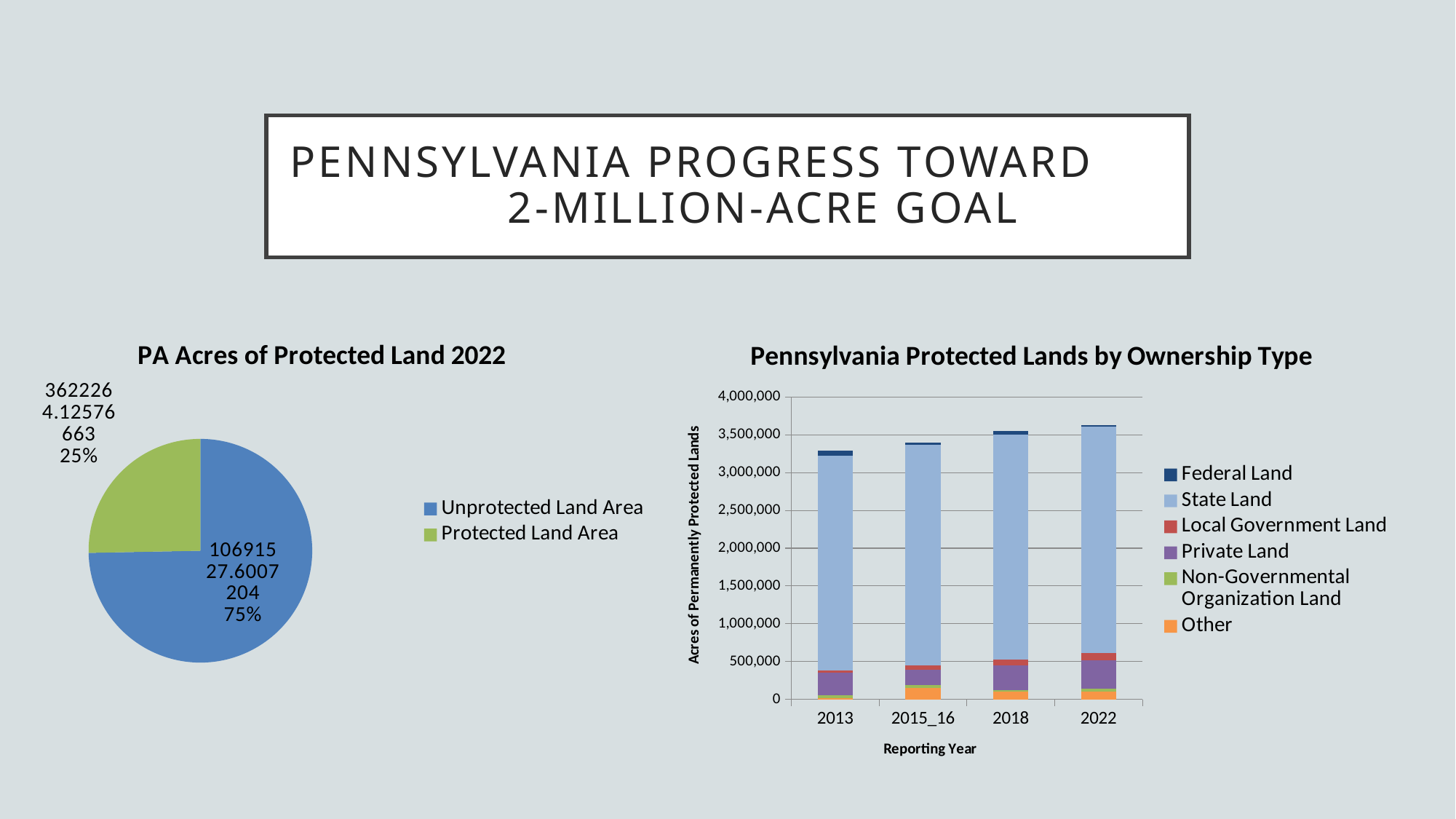
In the pie chart 'PA Acres of Protected Land 2022', which slice is larger, Unprotected Land Area or Protected Land Area? Unprotected Land Area What is the x-axis title of the chart 'Pennsylvania Protected Lands by Ownership Type'? Reporting Year In 'Pennsylvania Protected Lands by Ownership Type', is the total bar height for 2022 greater or less than 3,500,000? Greater How many reporting years are shown on the x axis of 'Pennsylvania Protected Lands by Ownership Type'? 4 How many series does the legend of 'Pennsylvania Protected Lands by Ownership Type' list? 6 In 'Pennsylvania Protected Lands by Ownership Type', which reporting year has the lowest total protected acres? 2013 What kind of chart is 'PA Acres of Protected Land 2022'? Pie chart In the pie chart 'PA Acres of Protected Land 2022', what percentage share does Protected Land Area have? 25% In the pie chart 'PA Acres of Protected Land 2022', what percentage share does Unprotected Land Area have? 75% In 'Pennsylvania Protected Lands by Ownership Type', do the total protected acres rise or fall from 2013 to 2022? Rise What kind of chart is 'Pennsylvania Protected Lands by Ownership Type'? Stacked bar chart How many slices does the pie chart 'PA Acres of Protected Land 2022' have? 2